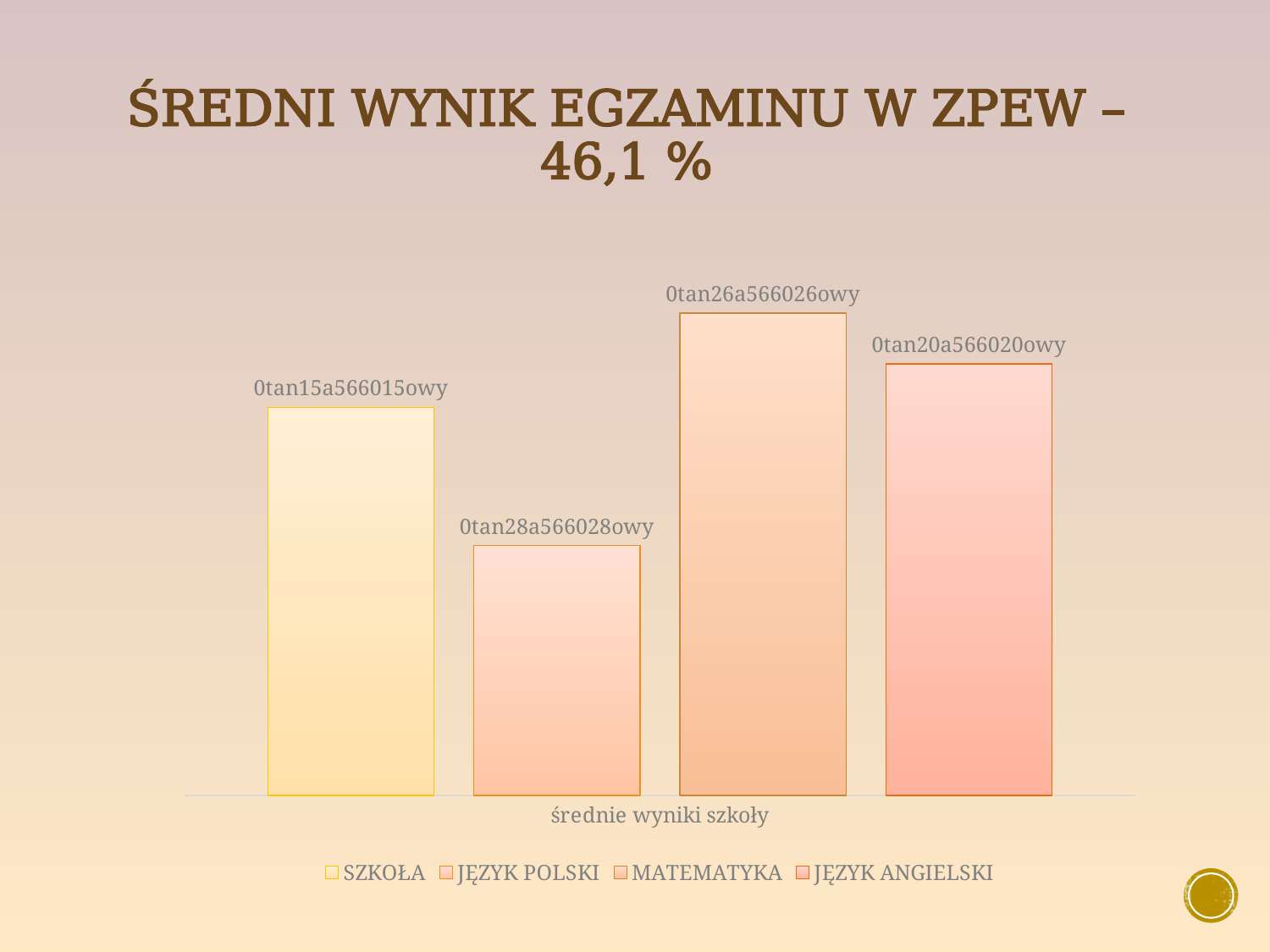
Which series has the lowest bar? JĘZYK POLSKI Which is larger, the bar for MATEMATYKA or the bar for JĘZYK ANGIELSKI? MATEMATYKA What is the category label shown under the bars on the x axis? średnie wyniki szkoły How many bars are plotted in the chart? 4 How many series does the legend list? 4 What average exam result is stated in the slide title? 46,1 % What kind of chart is shown on the slide? bar chart Which is larger, the bar for SZKOŁA or the bar for JĘZYK POLSKI? SZKOŁA Which series has the highest bar? MATEMATYKA Which is larger, the bar for SZKOŁA or the bar for JĘZYK ANGIELSKI? JĘZYK ANGIELSKI